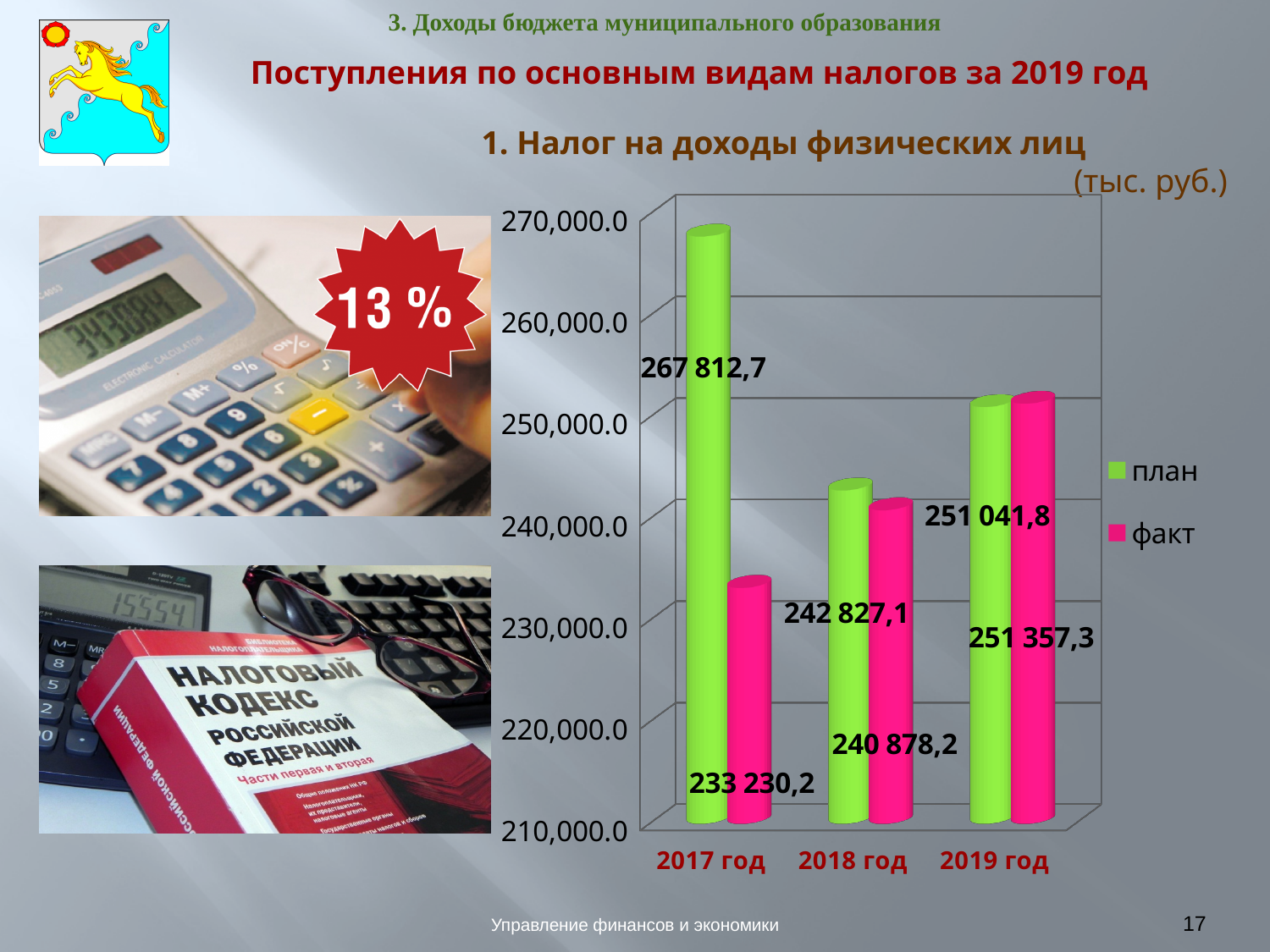
What is the план value for 2017 год? 267 812,7 What is the факт value for 2018 год? 240 878,2 Is the факт value for 2017 год greater or less than 240,000.0? less Does the факт value rise or fall from 2017 год to 2019 год? rise How many series does the legend list? 2 Which year has the highest план value? 2017 год What is the difference between план and факт for 2018 год? 1 948,9 How many years are shown on the x axis? 3 Which year has the lowest факт value? 2017 год What is the факт value for 2019 год? 251 357,3 Which is larger for 2019 год, план or факт? факт What is the difference between план and факт for 2017 год? 34 582,5